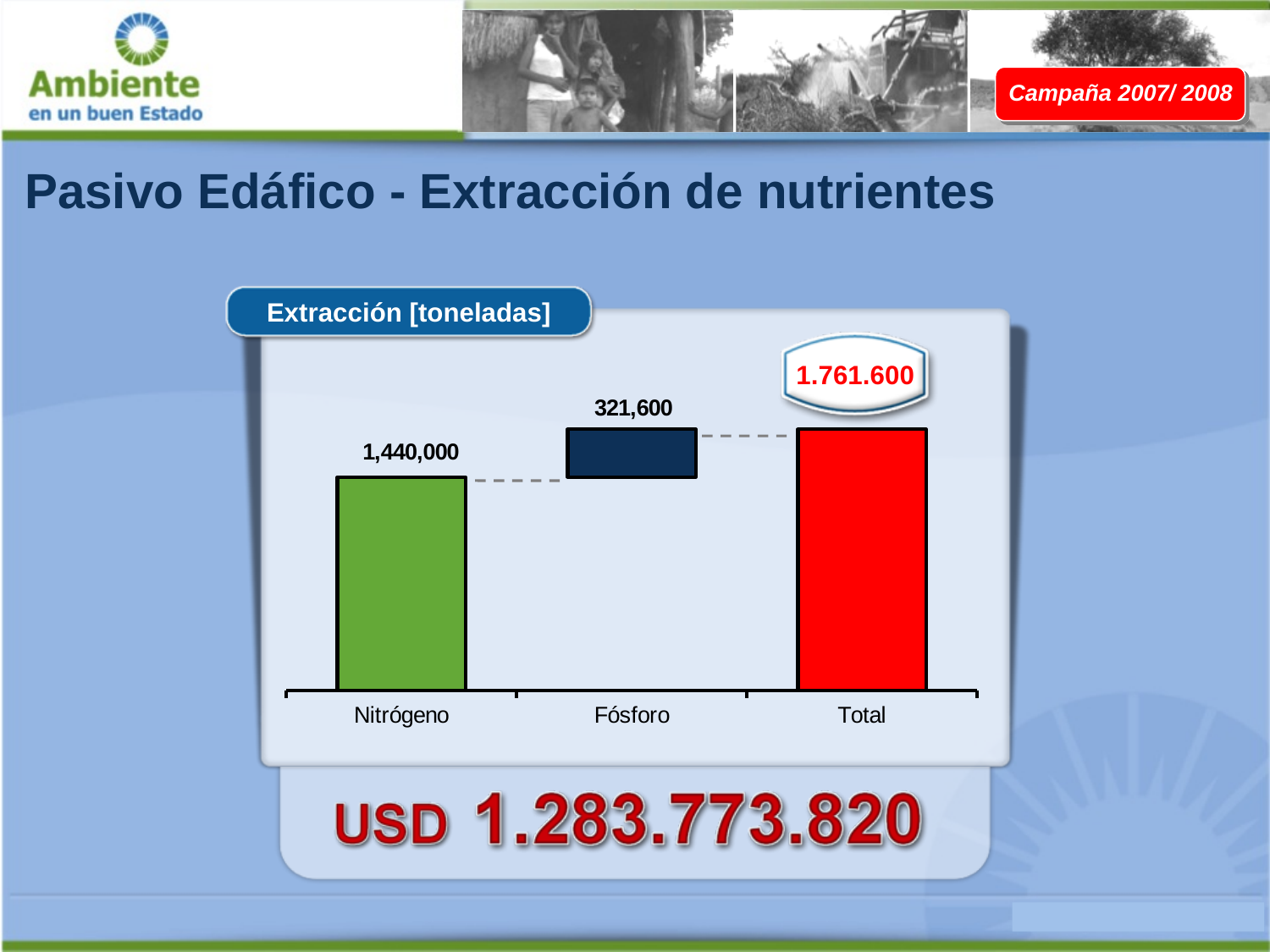
Which is larger in the Extracción [toneladas] chart, Nitrógeno or Fósforo? Nitrógeno What colour is the Total bar in the Extracción [toneladas] chart? Red Which category has the highest value in the Extracción [toneladas] chart? Total Which category has the lowest value in the Extracción [toneladas] chart? Fósforo What kind of chart is used to show the Extracción [toneladas] data? Bar chart What is the value for Nitrógeno in the Extracción [toneladas] chart? 1,440,000 What value is shown for Total in the Extracción [toneladas] chart? 1.761.600 What is the difference between the Nitrógeno and Fósforo values in the Extracción [toneladas] chart? 1,118,400 What is the value for Fósforo in the Extracción [toneladas] chart? 321,600 How many categories are shown on the x axis of the Extracción [toneladas] chart? 3 What is the title of the chart on the slide? Extracción [toneladas]